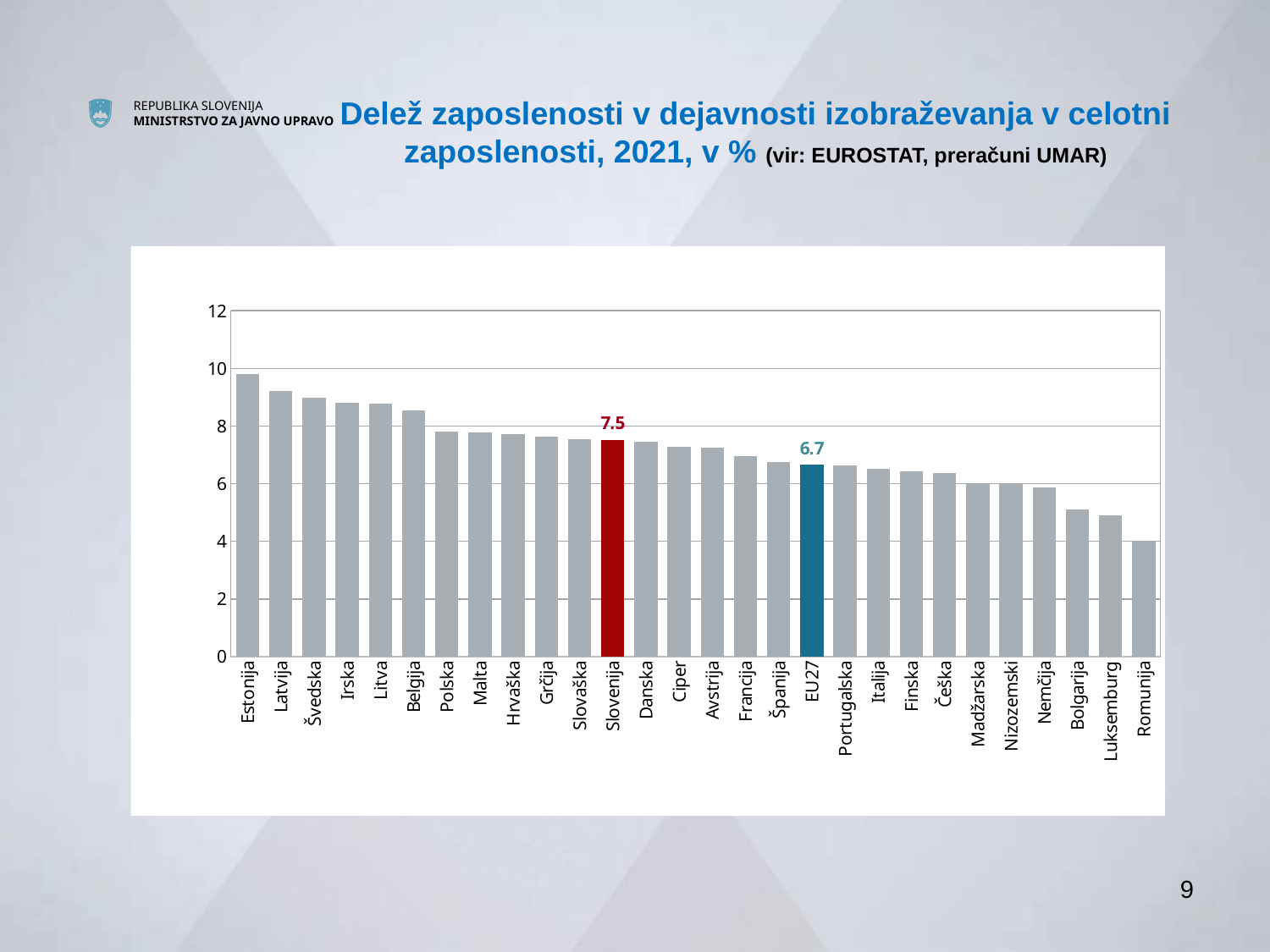
Which country has the lowest value? Romunija What is the value for EU27? 6.7 Is the value for Romunija greater or less than 6? less What is the difference between the values for Slovenija and EU27? 0.8 Which country has the highest value? Estonija What is the value for Slovenija? 7.5 What type of chart is shown on the slide? bar chart Is the value for Luksemburg greater or less than 6? less Which is larger, the value for Slovenija or the value for EU27? Slovenija How many bars are plotted in the chart? 28 Is the value for Estonija greater or less than 8? greater Do the values rise or fall from left to right along the x axis? fall